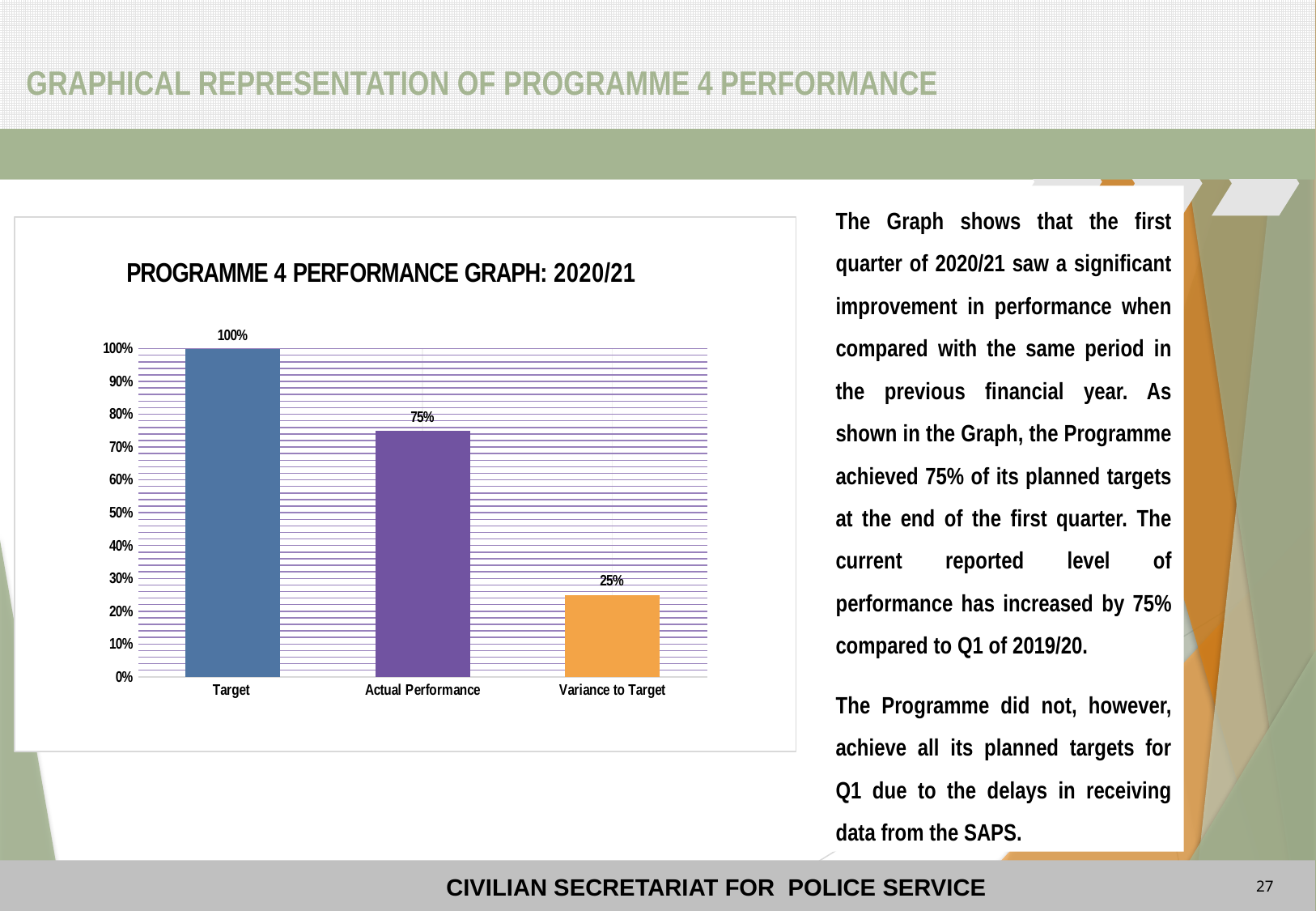
What is the difference between the Target and Actual Performance values? 25% What is the value for Variance to Target? 25% Is the value for Actual Performance greater or less than 50%? greater How many categories are shown on the x axis? 3 What is the difference between the Actual Performance and Variance to Target values? 50% Which category has the lowest value? Variance to Target What is the value for Target? 100% What kind of chart is shown? bar chart Which category has the highest value? Target What is the value for Actual Performance? 75% What is the title of the chart? PROGRAMME 4 PERFORMANCE GRAPH: 2020/21 Which is larger, Actual Performance or Variance to Target? Actual Performance